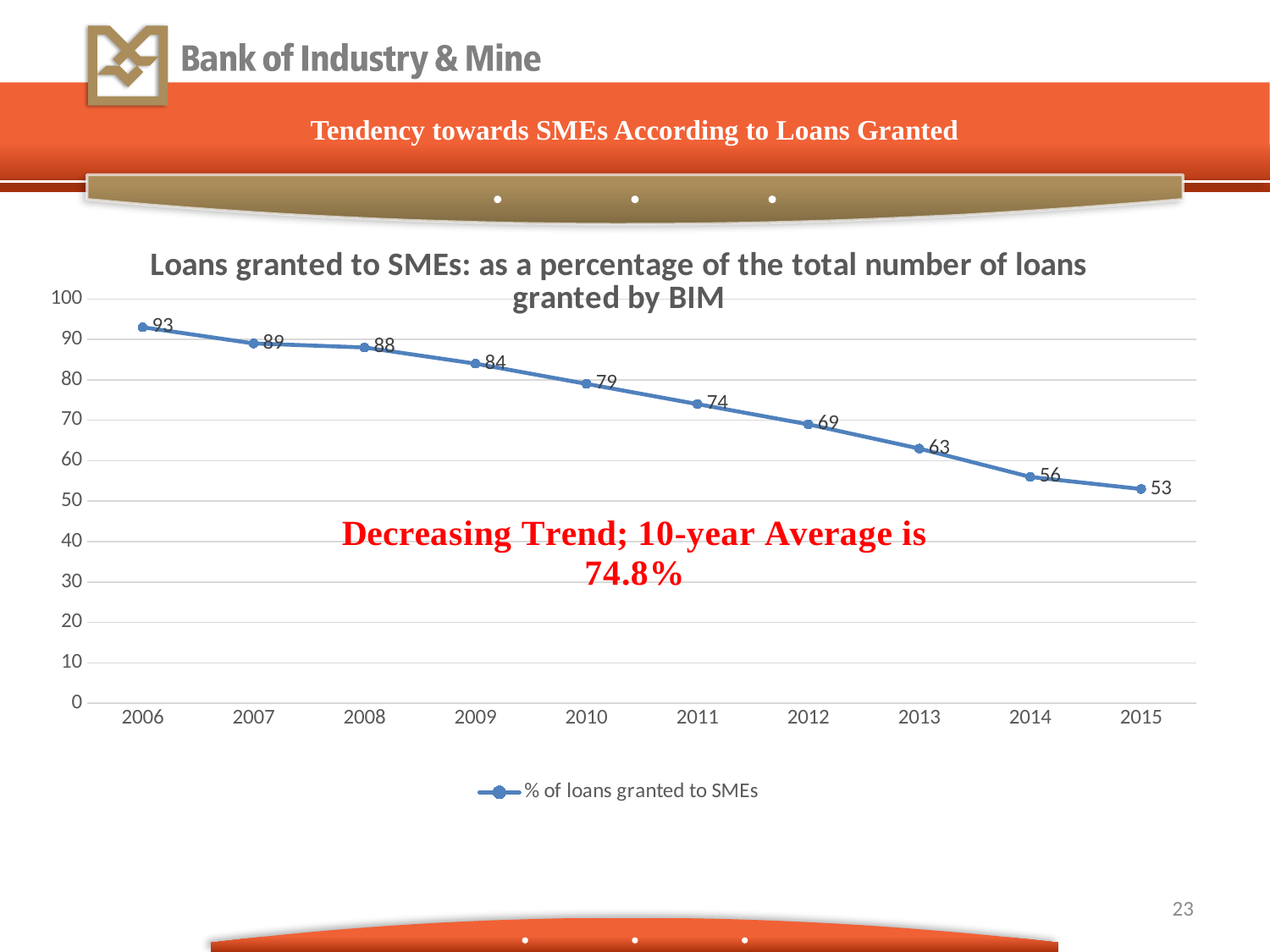
Do the values rise or fall from 2006 to 2015? fall Is the value for 2013 greater or less than 70? less What is the value for 2015? 53 What is the value for 2006? 93 What is the difference between the values for 2006 and 2015? 40 How many series does the legend list? 1 How many years are plotted on the x axis? 10 Which year has the lowest value? 2015 Which year has the highest value? 2006 What kind of chart is shown? line chart What is the value for 2010? 79 Which is larger, the value for 2009 or the value for 2012? 2009